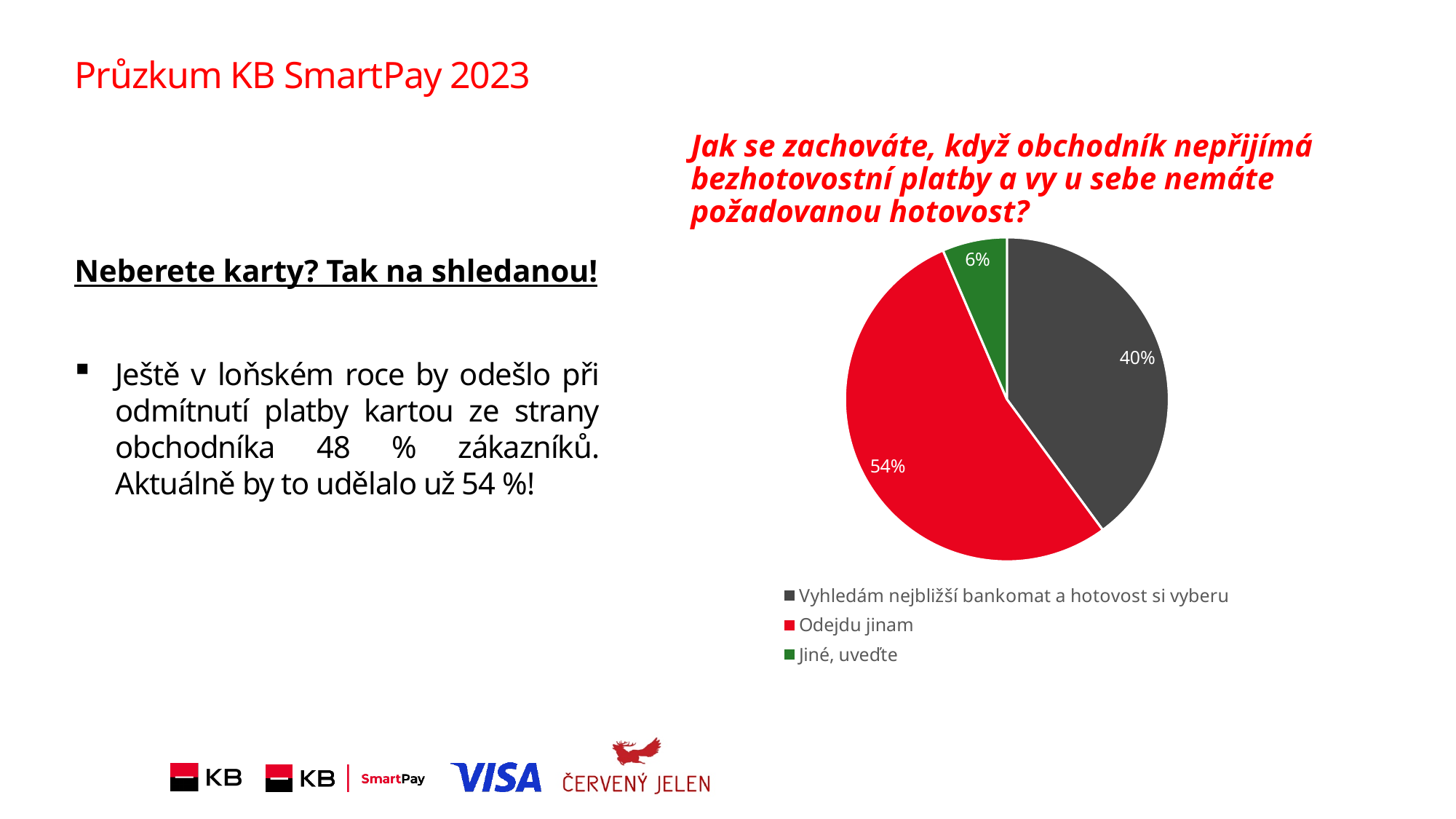
Which is larger: the share for "Odejdu jinam" or the share for "Vyhledám nejbližší bankomat a hotovost si vyberu"? Odejdu jinam Which category has the smallest slice of the pie? Jiné, uveďte What is the title of the pie chart? Jak se zachováte, když obchodník nepřijímá bezhotovostní platby a vy u sebe nemáte požadovanou hotovost? What kind of chart is shown on the slide? pie chart What share of the pie does "Vyhledám nejbližší bankomat a hotovost si vyberu" represent? 40% What colour is the slice for "Odejdu jinam"? red How many categories does the pie chart have? 3 How many entries does the legend list? 3 What share of the pie does "Odejdu jinam" represent? 54% Which category has the largest slice of the pie? Odejdu jinam What is the value for "Jiné, uveďte"? 6% What is the difference between the shares for "Odejdu jinam" and "Vyhledám nejbližší bankomat a hotovost si vyberu"? 14%